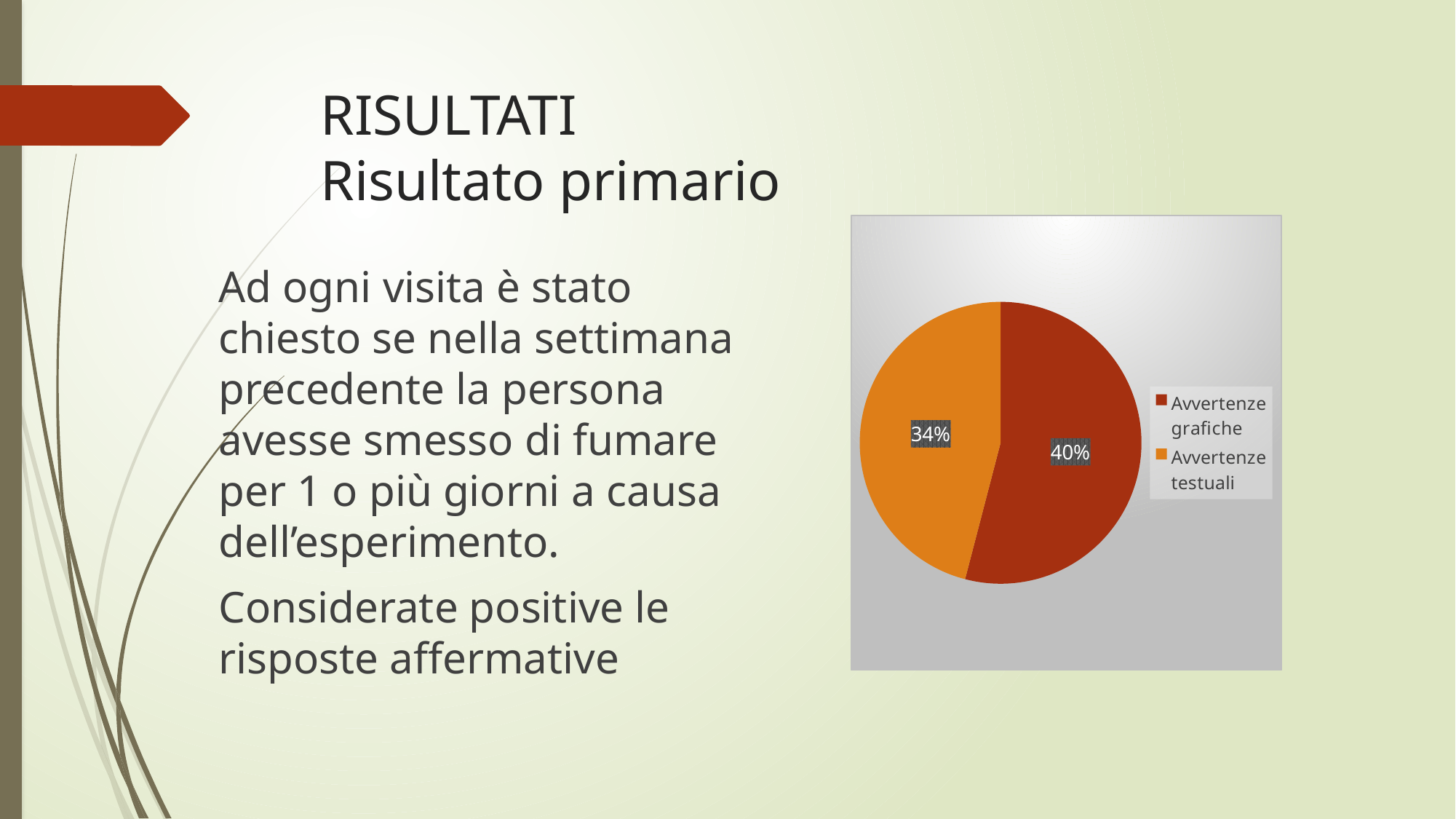
What kind of chart is shown on the slide? pie chart What value is labelled on the Avvertenze testuali slice of the pie chart? 34% What is the difference between the labelled values for Avvertenze grafiche and Avvertenze testuali? 6% Which slice of the pie chart is the smallest? Avvertenze testuali Which has the larger labelled value, Avvertenze grafiche or Avvertenze testuali? Avvertenze grafiche Which slice of the pie chart is the largest? Avvertenze grafiche How many slices does the pie chart have? 2 What colour is the Avvertenze testuali slice in the pie chart? orange What value is labelled on the Avvertenze grafiche slice of the pie chart? 40% How many entries does the legend of the pie chart list? 2 What colour is the Avvertenze grafiche slice in the pie chart? dark red